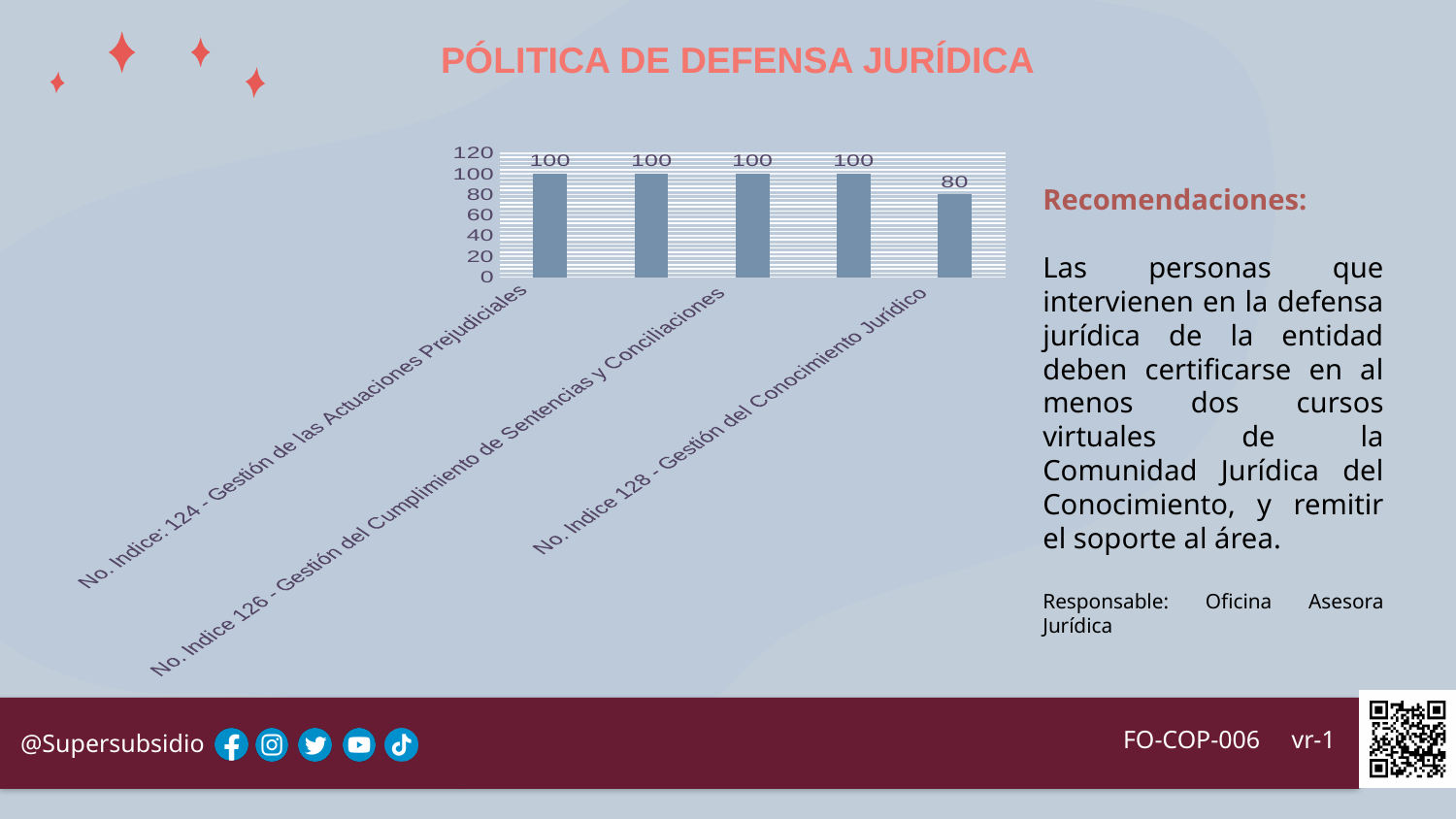
What is the highest value shown on the vertical axis of the chart? 120 How many bars in the chart have a value of 100? 4 Which is larger: the value for 'No. Indice 126 - Gestión del Cumplimiento de Sentencias y Conciliaciones' or the value for 'No. Indice 128 - Gestión del Conocimiento Jurídico'? No. Indice 126 - Gestión del Cumplimiento de Sentencias y Conciliaciones What is the value for 'No. Indice: 124 - Gestión de las Actuaciones Prejudiciales'? 100 How many bars are plotted in the chart? 5 What is the value for 'No. Indice 128 - Gestión del Conocimiento Jurídico'? 80 What is the value for 'No. Indice 126 - Gestión del Cumplimiento de Sentencias y Conciliaciones'? 100 What is the title of the slide containing the chart? PÓLITICA DE DEFENSA JURÍDICA What kind of chart is shown on the slide? bar chart Which category has the lowest value in the chart? No. Indice 128 - Gestión del Conocimiento Jurídico Is the value for 'No. Indice 128 - Gestión del Conocimiento Jurídico' greater or less than 100? less What is the difference between the value for 'No. Indice: 124 - Gestión de las Actuaciones Prejudiciales' and the value for 'No. Indice 128 - Gestión del Conocimiento Jurídico'? 20